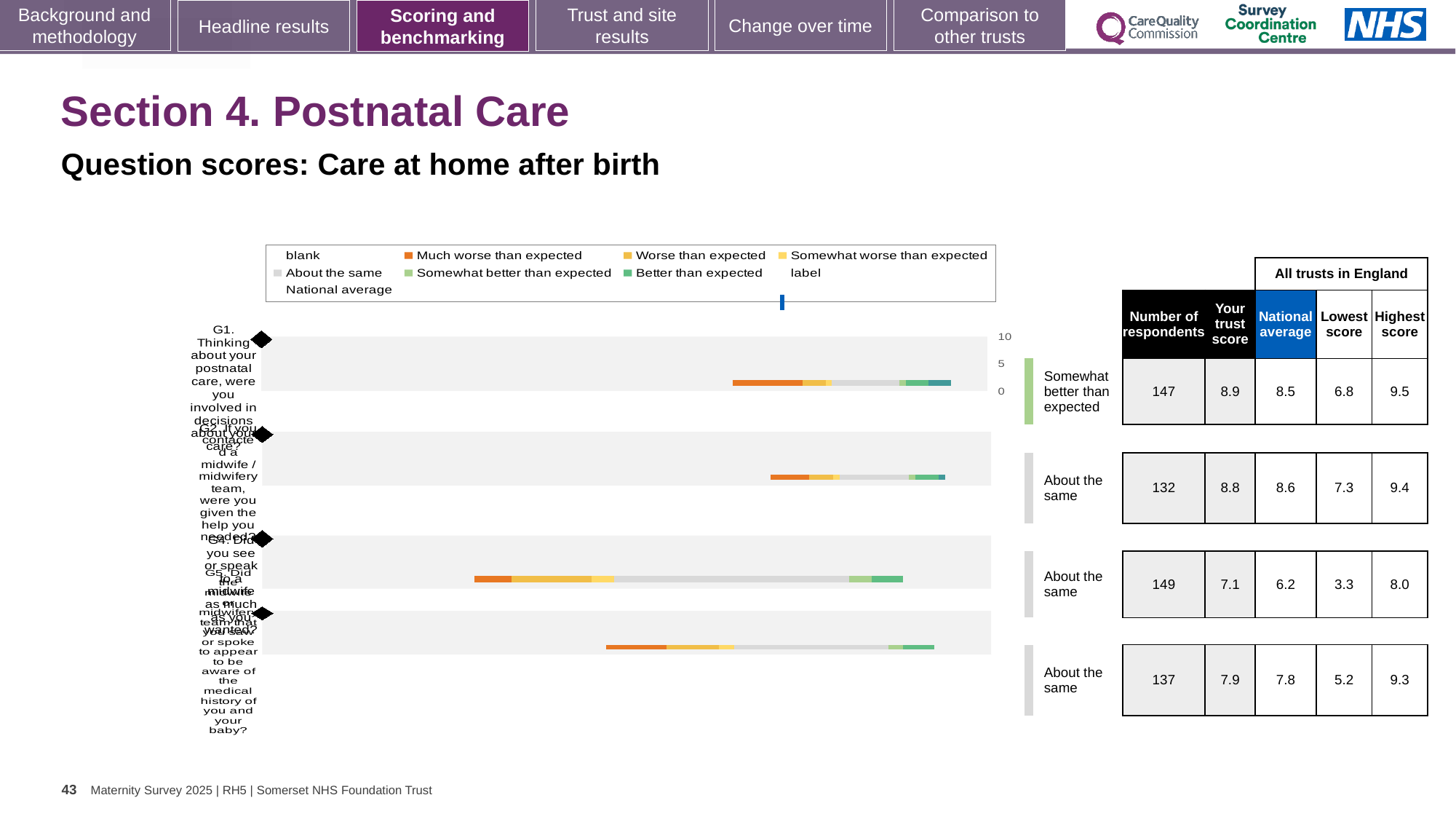
Which row in the table beside the chart has the highest number of respondents? the third row (149) What kind of chart is shown on the slide? bar chart In the table beside the chart, what is the lowest score for the fourth row? 5.2 In the table beside the chart, what is the number of respondents for the first row (G1)? 147 In the table beside the chart, for the second row, which is larger: the trust score or the national average? the trust score (8.8) How many question rows (bars) are plotted in the chart? 4 In the table beside the chart, what is the national average for the third row? 6.2 Which row in the table beside the chart has the lowest trust score? the third row (7.1) What benchmark label is shown next to the second (G2) bar? About the same In the table beside the chart, what is the trust score for the first row (G1)? 8.9 In the table beside the chart, what is the difference between the trust score and the national average for the third row? 0.9 What benchmark label is shown next to the first (G1) bar? Somewhat better than expected